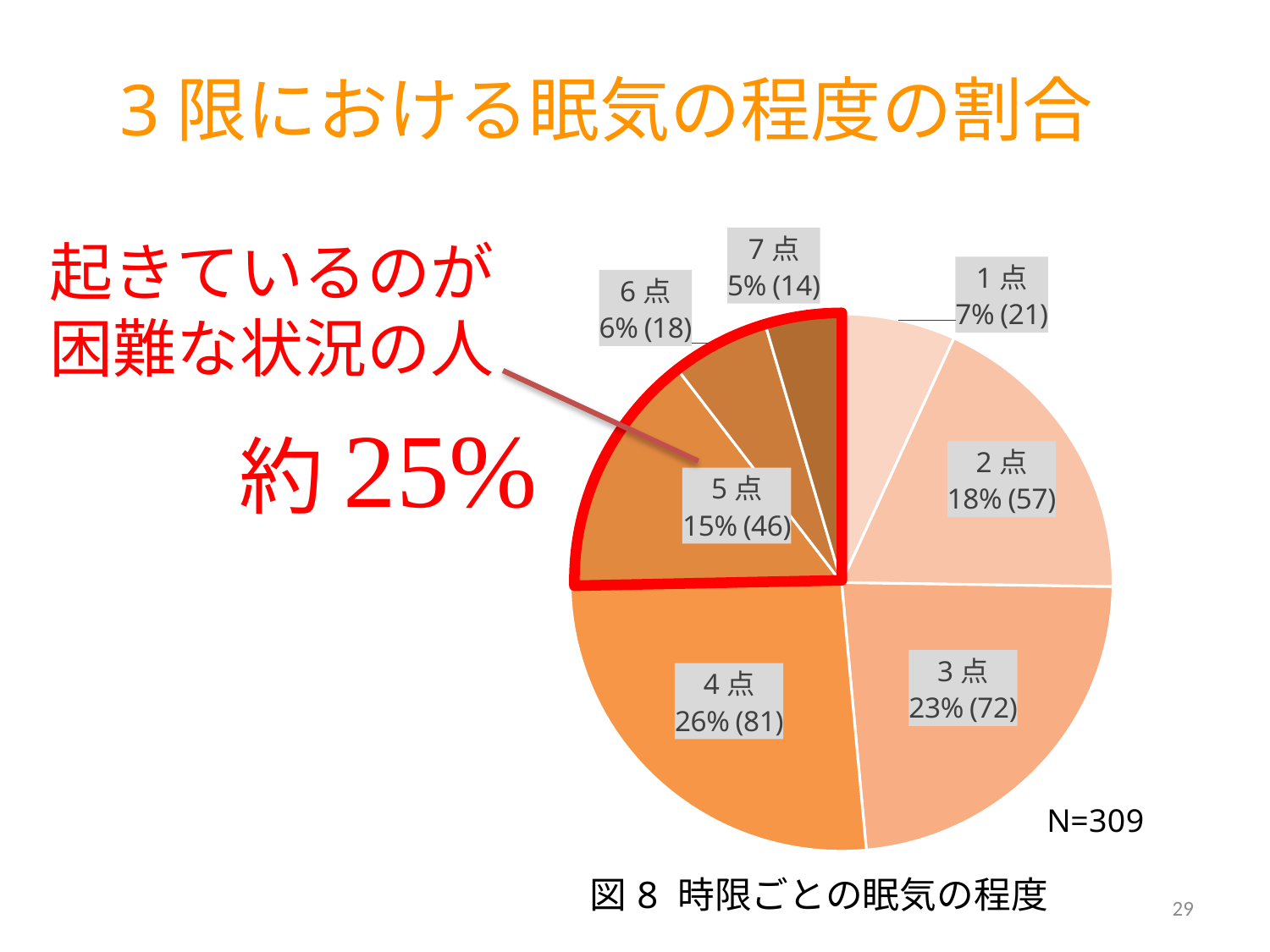
Which category has the largest share of the pie? 4点 What is the combined count of respondents for 5点, 6点 and 7点? 78 Which has a larger share, 2点 or 3点? 3点 What is the total number of respondents (N) shown on the slide? 309 How many respondents are in the 3点 category? 72 What kind of chart is shown on the slide? pie chart How many slices does the pie chart have? 7 What percentage share does the 4点 slice have? 26% What is the title of the slide? ３限における眠気の程度の割合 What is the difference in respondent count between 4点 and 3点? 9 Which category has the smallest share of the pie? 7点 What is the percentage shown for 5点? 15%